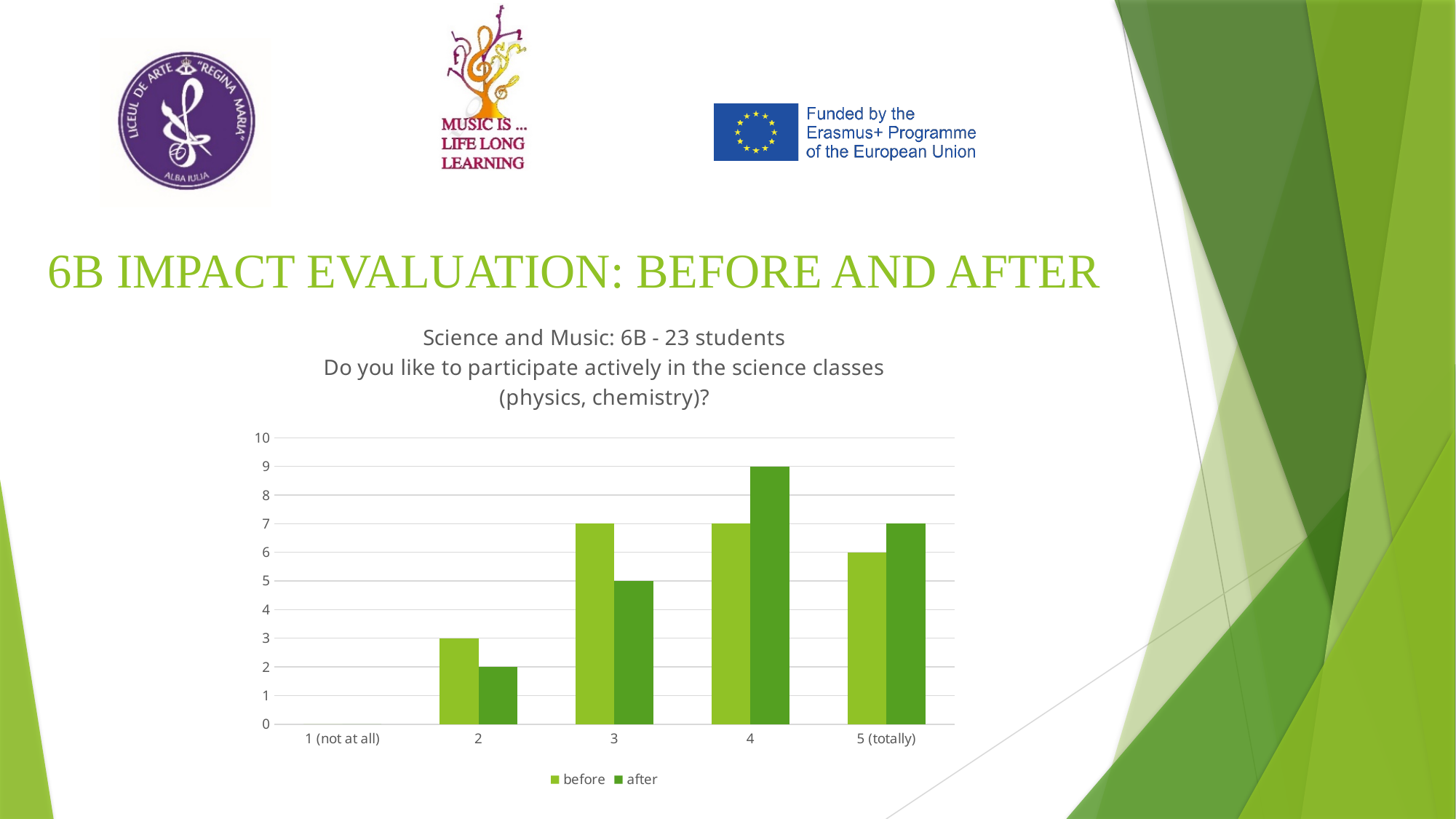
Which category has the highest 'after' value? 4 What kind of chart is shown on the slide? bar chart What are the two legend entries of the chart? before, after What is the 'after' value for category 3? 5 Which category has the lowest 'before' value? 1 (not at all) What is the 'before' value for '5 (totally)'? 6 How many series does the legend list? 2 For category 3, which is larger, the 'before' value or the 'after' value? before What is the 'after' value for category 4? 9 What is the difference between the 'after' and 'before' values for category 4? 2 How many categories are shown on the x axis? 5 What is the 'before' value for category 2? 3